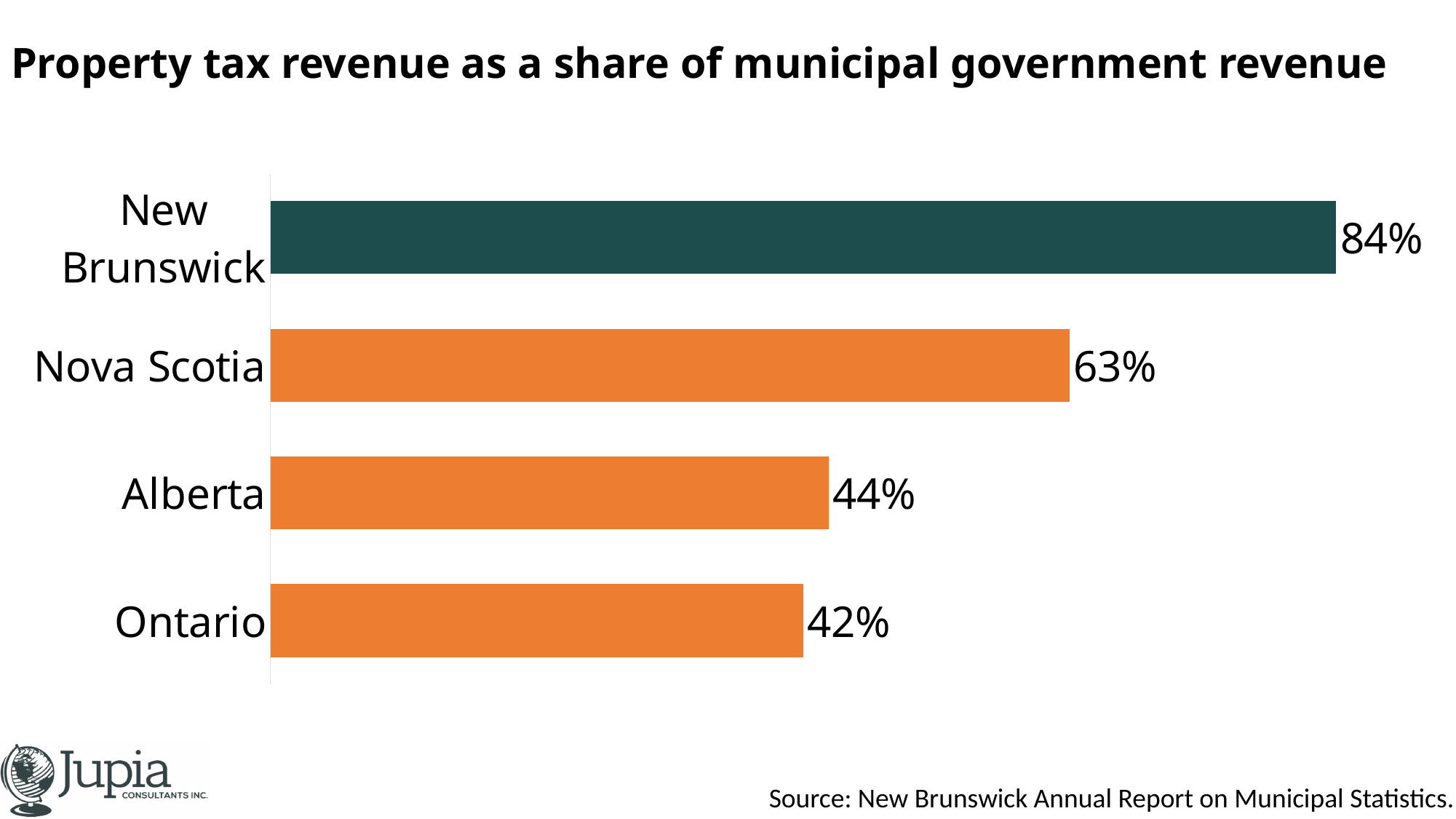
What is the property tax revenue share for Nova Scotia? 63% Which has a larger property tax revenue share, Nova Scotia or Alberta? Nova Scotia What is the property tax revenue share for Alberta? 44% How many provinces are shown in the chart? 4 What is the difference between Alberta's and Ontario's property tax revenue shares? 2% What is the difference between New Brunswick's and Nova Scotia's property tax revenue shares? 21% Which province has the lowest property tax revenue share? Ontario What kind of chart is shown on the slide? Bar chart What is the property tax revenue share for New Brunswick? 84% Which province has the highest property tax revenue share? New Brunswick What is the property tax revenue share for Ontario? 42% Which province's bar is shown in a different colour from the others? New Brunswick